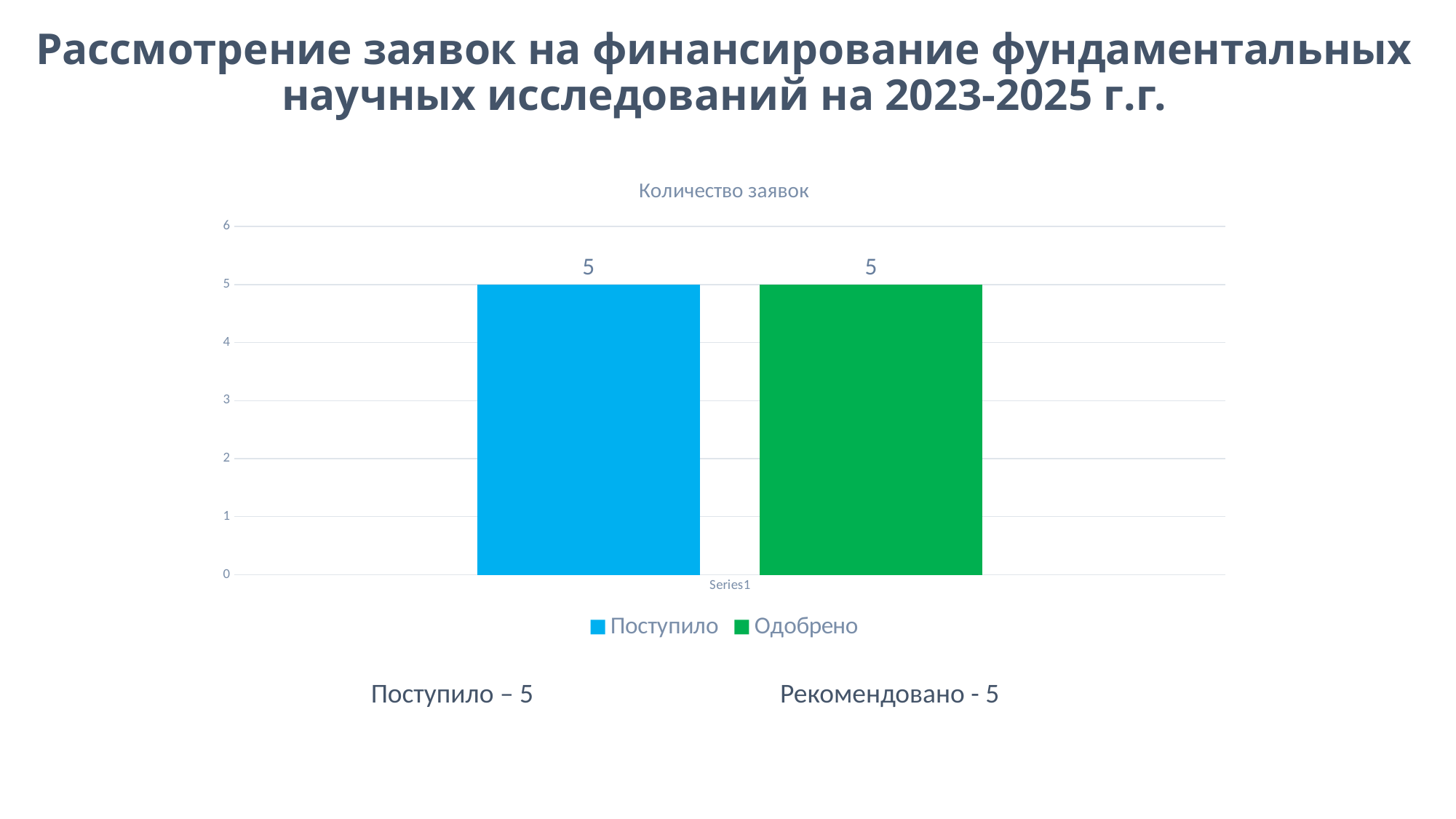
How many bars are plotted in the chart? 2 What kind of chart is shown on the slide? bar chart What is the difference between the Поступило and Одобрено values? 0 How many series does the legend list? 2 What colour is the Одобрено bar? green What is the title of the chart? Количество заявок What is the highest value shown on the vertical axis? 6 What is the value of the Поступило bar? 5 Is the value for Одобрено greater or less than 4? greater What is the value of the Одобрено bar? 5 Is the value for Поступило greater or less than 6? less